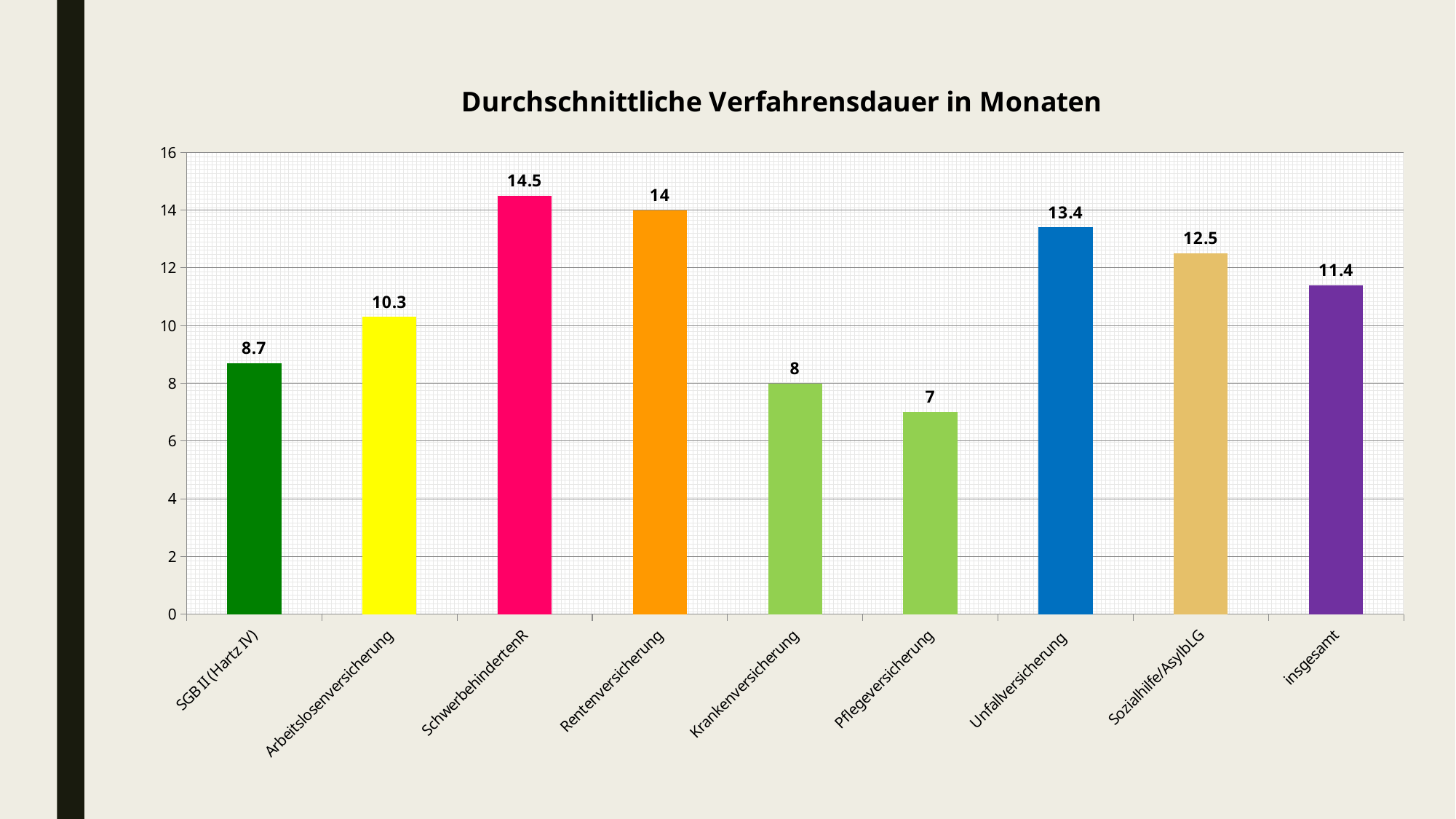
What is the value for Schwerbehindertenrecht (SchwerbehindertenR)? 14.5 What is the difference between the values for Unfallversicherung and Sozialhilfe/AsylbLG? 0.9 What is the value for Pflegeversicherung? 7 What is the value for insgesamt? 11.4 Which is larger, the value for SGB II (Hartz IV) or the value for Arbeitslosenversicherung? Arbeitslosenversicherung What kind of chart is shown on the slide? bar chart How many categories are shown on the x axis? 9 What is the difference between the values for Rentenversicherung and Krankenversicherung? 6 What is the title of the chart? Durchschnittliche Verfahrensdauer in Monaten Which category has the highest value? SchwerbehindertenR Which category has the lowest value? Pflegeversicherung Is the value for Unfallversicherung greater or less than 12? greater